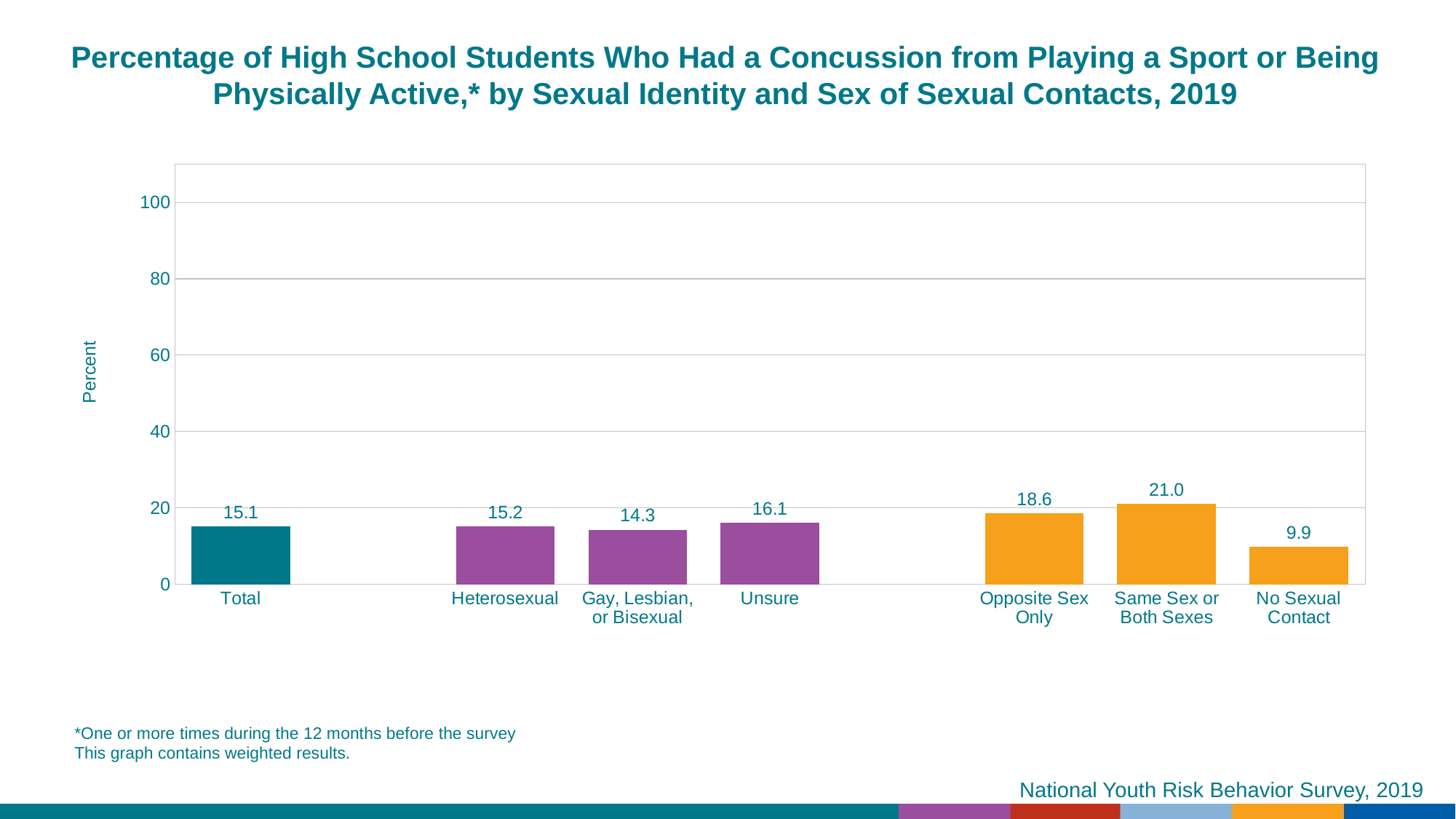
What kind of chart is this? Bar chart What is the difference between the values for Same Sex or Both Sexes and Opposite Sex Only? 2.4 What is the value for No Sexual Contact? 9.9 Is the value for Same Sex or Both Sexes greater or less than 20? greater Which category has the highest value? Same Sex or Both Sexes What is the value for Total? 15.1 Which category has the lowest value? No Sexual Contact Which is larger, the value for Opposite Sex Only or the value for Heterosexual? Opposite Sex Only What is the difference between the values for Unsure and Gay, Lesbian, or Bisexual? 1.8 What is the value for Gay, Lesbian, or Bisexual? 14.3 What is the value for Same Sex or Both Sexes? 21.0 How many categories are shown on the x axis? 7